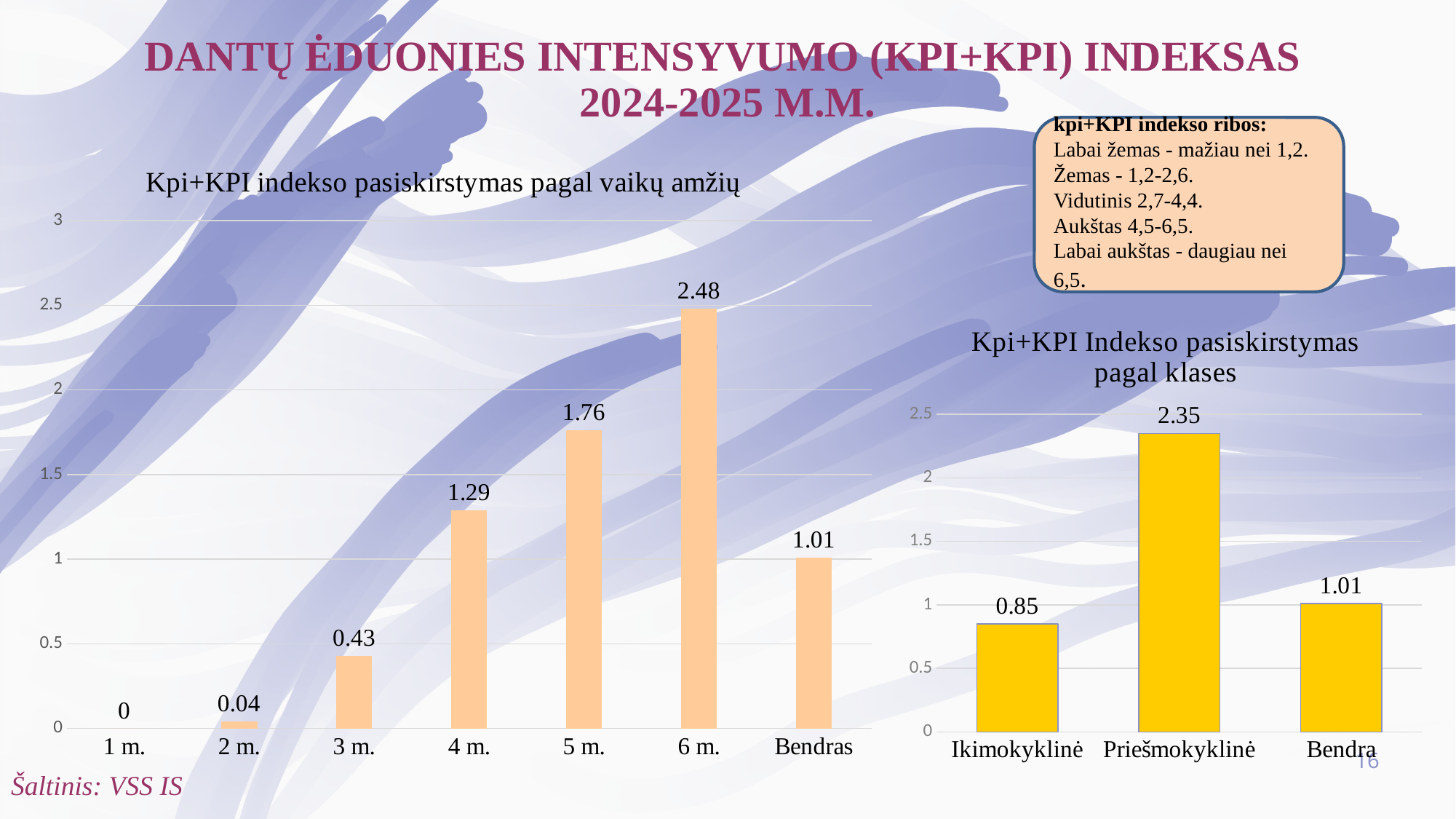
In the chart 'Kpi+KPI indekso pasiskirstymas pagal vaikų amžių', do the values rise or fall from 1 m. to 6 m.? rise What kind of chart is 'Kpi+KPI Indekso pasiskirstymas pagal klases'? bar chart In the chart 'Kpi+KPI Indekso pasiskirstymas pagal klases', what is the value for Ikimokyklinė? 0.85 In the chart 'Kpi+KPI indekso pasiskirstymas pagal vaikų amžių', what is the value for 2 m.? 0.04 In the chart 'Kpi+KPI indekso pasiskirstymas pagal vaikų amžių', what is the difference between the values for 6 m. and 5 m.? 0.72 In the chart 'Kpi+KPI Indekso pasiskirstymas pagal klases', which category has the highest value? Priešmokyklinė In the chart 'Kpi+KPI indekso pasiskirstymas pagal vaikų amžių', how many categories are shown on the x axis? 7 In the chart 'Kpi+KPI Indekso pasiskirstymas pagal klases', what is the value for Priešmokyklinė? 2.35 In the chart 'Kpi+KPI Indekso pasiskirstymas pagal klases', what is the difference between the values for Priešmokyklinė and Ikimokyklinė? 1.50 In the chart 'Kpi+KPI indekso pasiskirstymas pagal vaikų amžių', which age group has the highest value? 6 m. In the chart 'Kpi+KPI indekso pasiskirstymas pagal vaikų amžių', what is the value for 4 m.? 1.29 In the chart 'Kpi+KPI indekso pasiskirstymas pagal vaikų amžių', which category has the lowest value? 1 m.